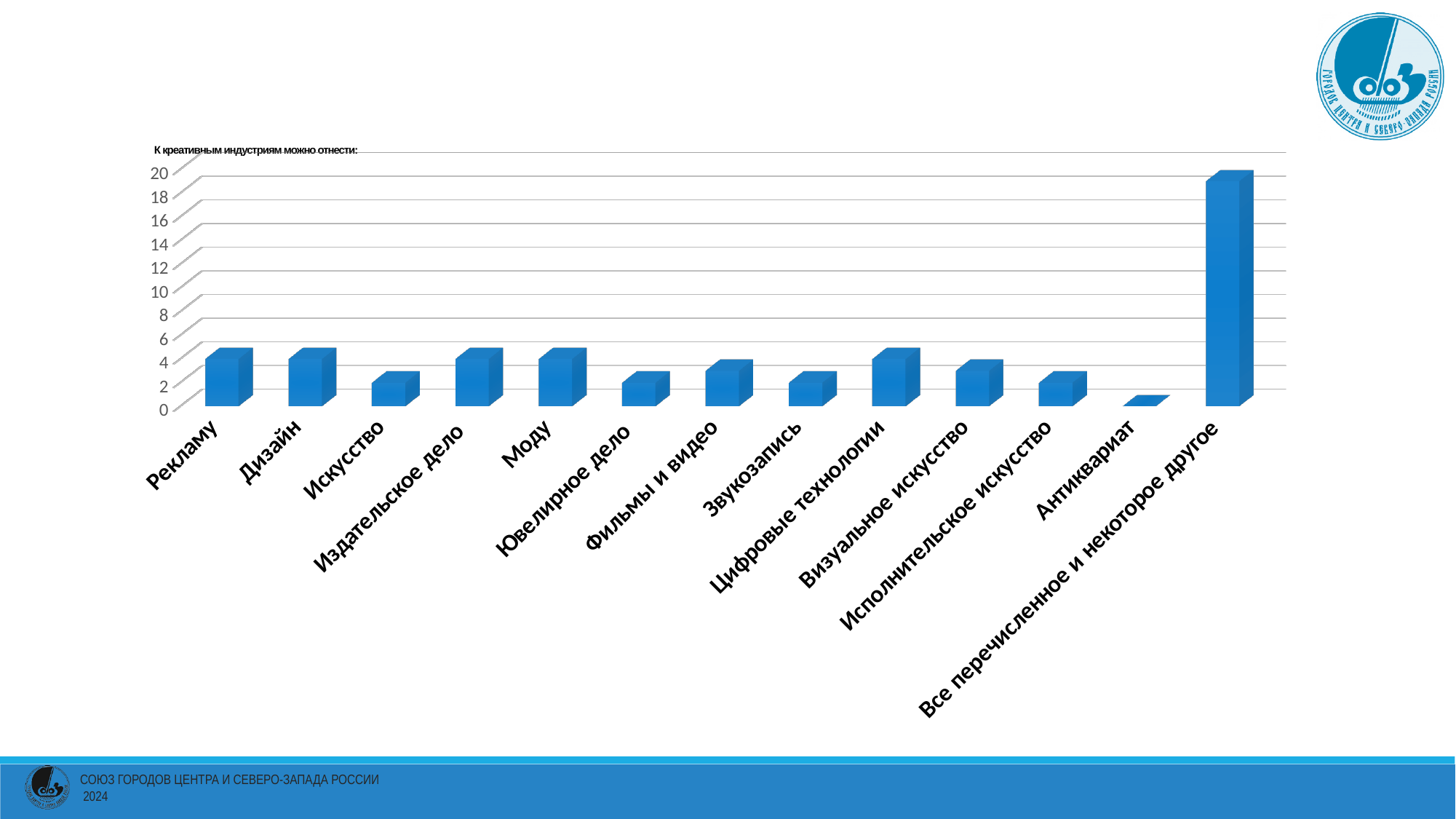
What kind of chart is shown on the slide? Bar chart Is the value for Антиквариат greater or less than 2? less Which category has the lowest value in the chart? Антиквариат How many categories are shown on the x axis of the chart? 13 Is the value for Рекламу greater or less than 10? less What colour are the bars in the chart? Blue Which is larger, the value for Все перечисленное и некоторое другое or the value for Дизайн? Все перечисленное и некоторое другое Which category has the highest value in the chart? Все перечисленное и некоторое другое What is the title of the chart? К креативным индустриям можно отнести: Is the value for Искусство greater or less than 6? less Which is larger, the value for Цифровые технологии or the value for Антиквариат? Цифровые технологии